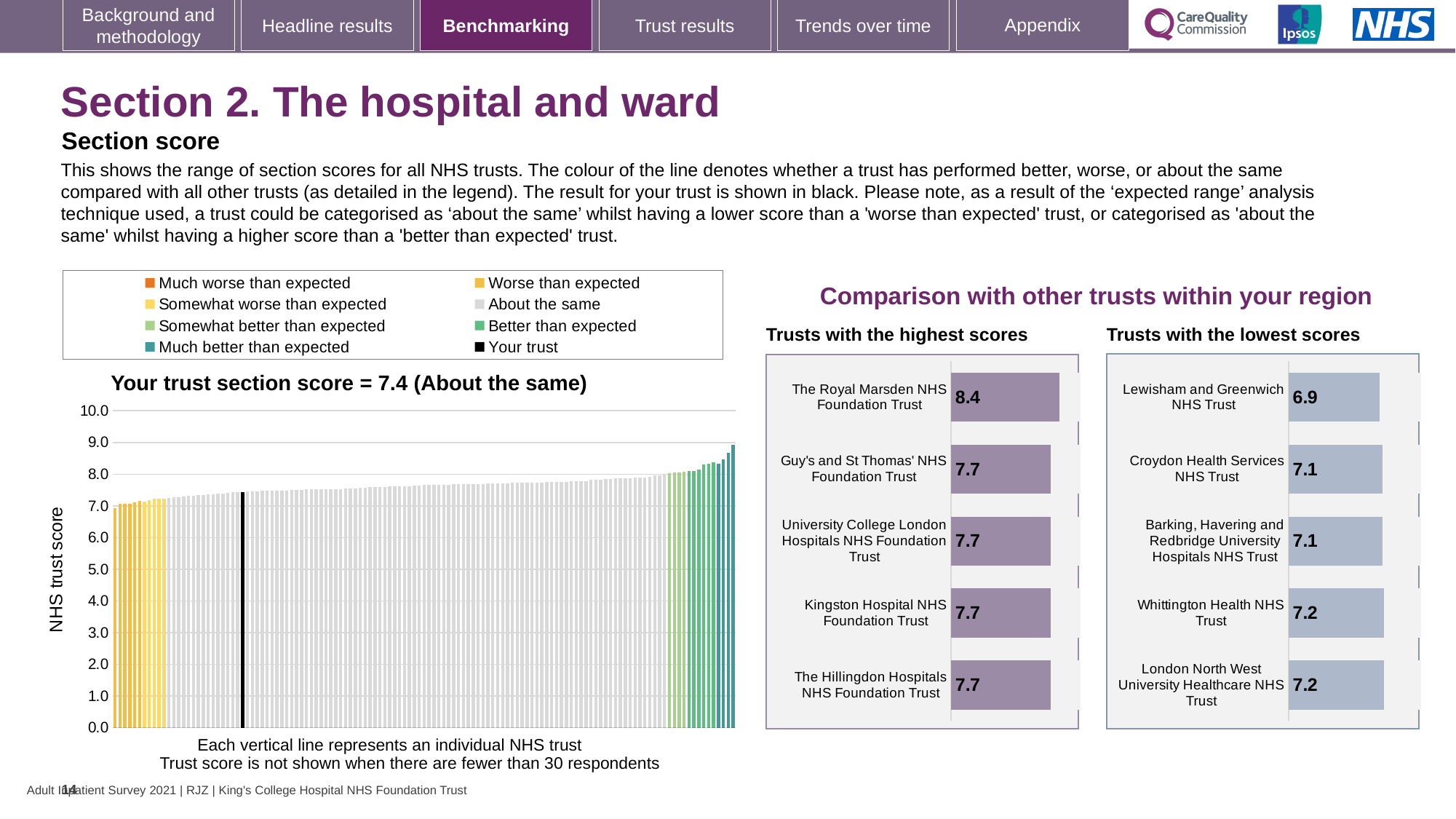
In the 'Trusts with the highest scores' chart, what is the score for Kingston Hospital NHS Foundation Trust? 7.7 In the 'Trusts with the lowest scores' chart, what is the score for Lewisham and Greenwich NHS Trust? 6.9 In the 'Trusts with the lowest scores' chart, which is larger: the score for Croydon Health Services NHS Trust or the score for Lewisham and Greenwich NHS Trust? Croydon Health Services NHS Trust In the main chart on the left, what is your trust's section score? 7.4 In the 'Trusts with the highest scores' chart, what is the score for The Royal Marsden NHS Foundation Trust? 8.4 In the 'Trusts with the lowest scores' chart, which trust has the lowest score? Lewisham and Greenwich NHS Trust In the 'Trusts with the lowest scores' chart, what is the score for Whittington Health NHS Trust? 7.2 In the 'Trusts with the highest scores' chart, what is the difference between the scores of The Royal Marsden NHS Foundation Trust and Guy's and St Thomas' NHS Foundation Trust? 0.7 How many entries does the legend of the main chart on the left list? 8 How many trusts are shown in the 'Trusts with the lowest scores' chart? 5 In the 'Trusts with the highest scores' chart, which trust has the highest score? The Royal Marsden NHS Foundation Trust In the main chart on the left, do the trust scores rise or fall from left to right along the x axis? rise